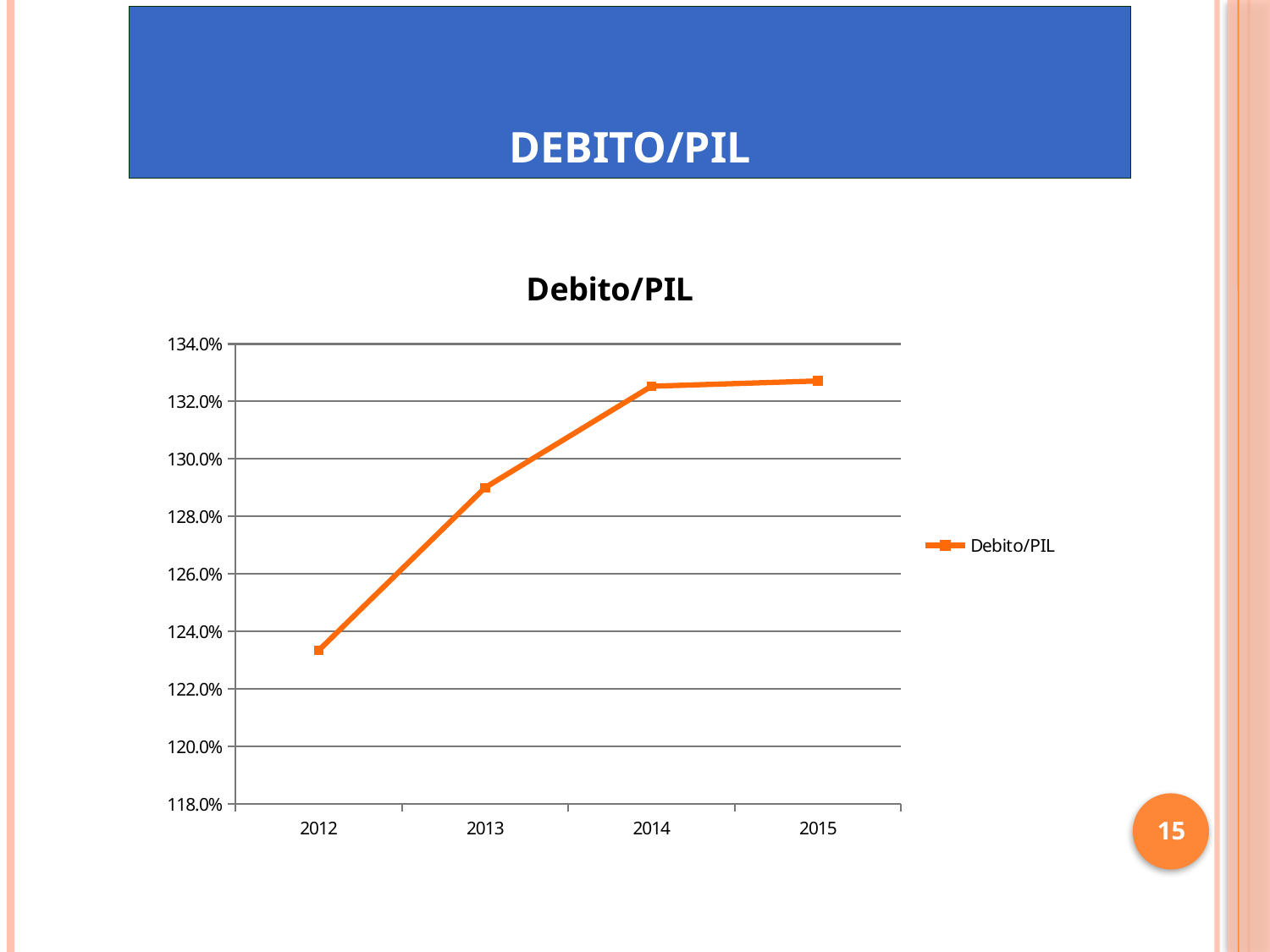
Which year has the larger Debito/PIL value, 2012 or 2013? 2013 Does the Debito/PIL value rise or fall from 2012 to 2015? rise Is the Debito/PIL value for 2014 greater or less than 132.0%? greater How many years are plotted on the x axis of the chart? 4 Is the Debito/PIL value for 2012 greater or less than 124.0%? less Is the Debito/PIL value for 2013 greater or less than 128.0%? greater What colour is the Debito/PIL line in the chart? orange What is the title of the chart? Debito/PIL Which year has the lowest Debito/PIL value? 2012 How many series does the chart's legend list? 1 What kind of chart is shown on the slide? line chart